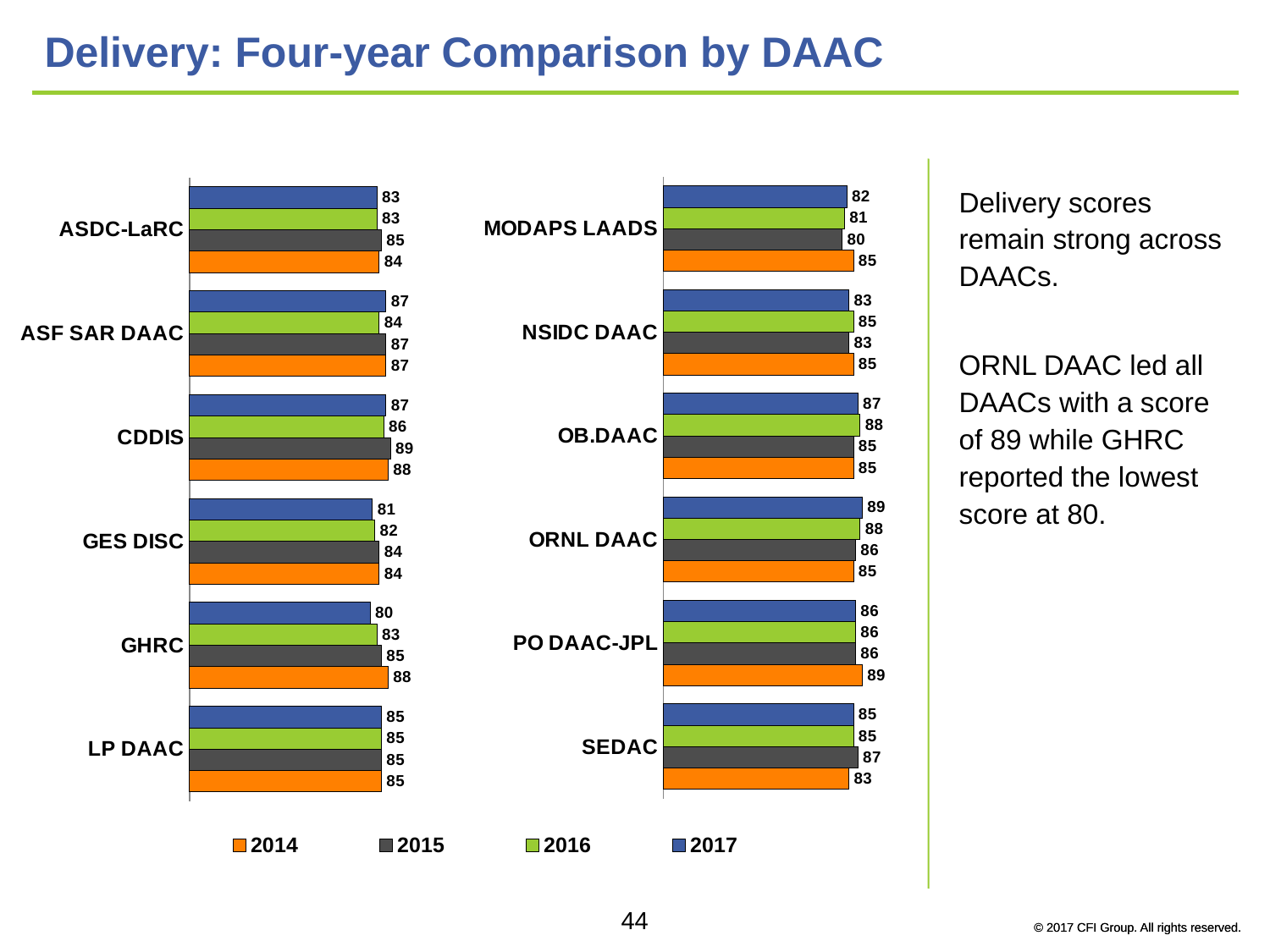
In the left chart, which DAAC has the lowest 2017 value? GHRC In the right chart, which DAAC has the highest 2017 value? ORNL DAAC What kind of chart is used on this slide? Bar chart In the left chart, what is the difference between the 2014 and 2017 values for GHRC? 8 How many DAACs are shown in the left chart? 6 How many series does the legend list? 4 In the left chart, what is the 2015 value for CDDIS? 89 In the right chart, what is the 2014 value for MODAPS LAADS? 85 In the right chart, do the values for ORNL DAAC rise or fall from 2014 to 2017? Rise In the right chart, what is the 2016 value for OB.DAAC? 88 In the right chart, which is larger for SEDAC, the 2015 value or the 2014 value? 2015 In the left chart, what is the 2017 value for GHRC? 80